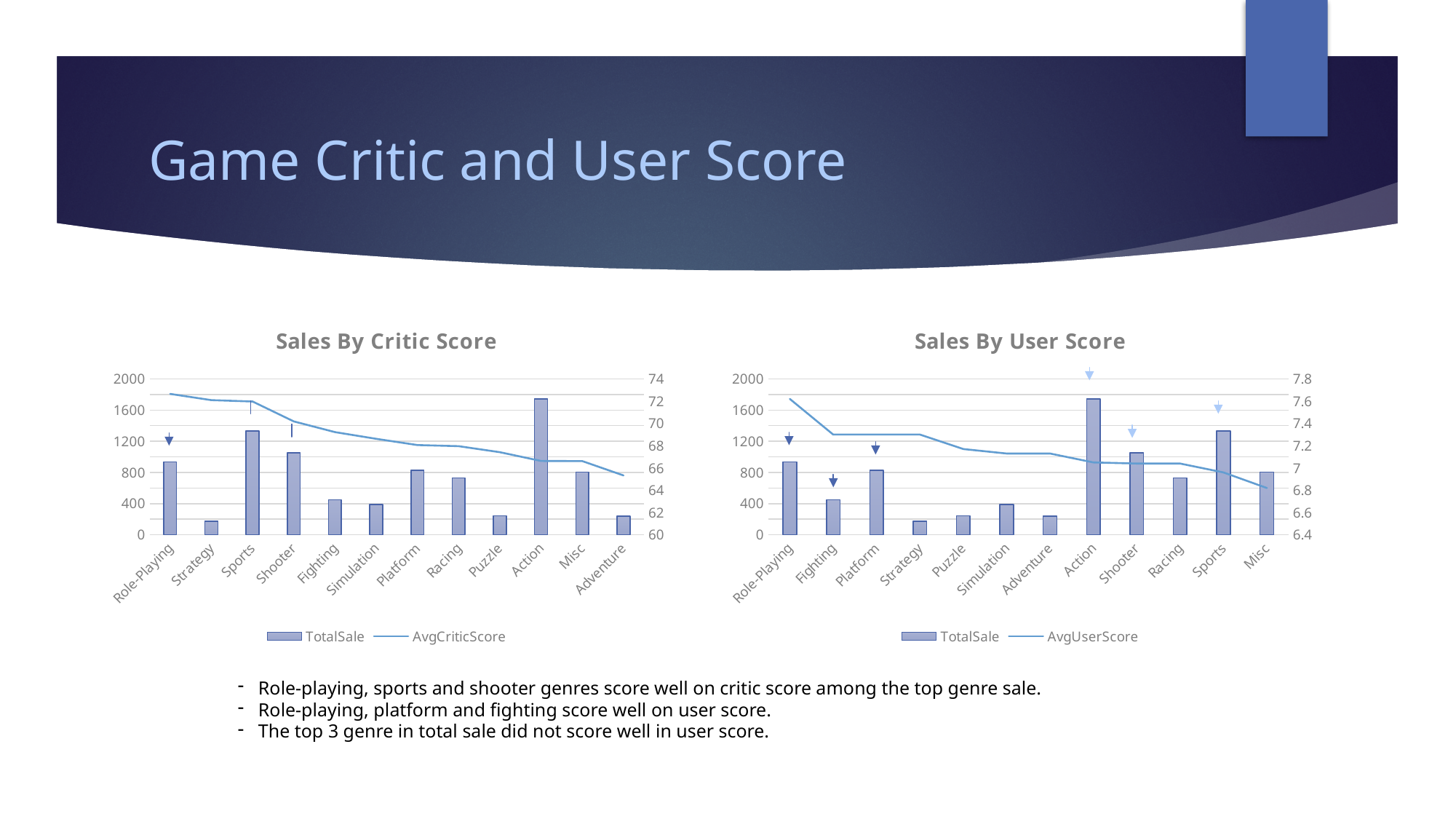
In the "Sales By Critic Score" chart, is the TotalSale value for Strategy greater or less than 400? less In the "Sales By Critic Score" chart, does the AvgCriticScore line generally rise or fall from left to right? fall In the "Sales By Critic Score" chart, which genre has the highest TotalSale bar? Action In the "Sales By User Score" chart, what are the two legend entries? TotalSale and AvgUserScore What type of chart is "Sales By Critic Score"? Combination bar and line chart In the "Sales By User Score" chart, is the TotalSale value for Role-Playing greater or less than 800? greater In the "Sales By Critic Score" chart, which has the larger TotalSale bar, Sports or Shooter? Sports In the "Sales By Critic Score" chart, how many genre categories are shown on the x axis? 12 In the "Sales By Critic Score" chart, how many series does the legend list? 2 In the "Sales By User Score" chart, which has the larger TotalSale bar, Platform or Fighting? Platform In the "Sales By Critic Score" chart, is the TotalSale value for Action greater or less than 1600? greater In the "Sales By User Score" chart, which genre has the highest TotalSale bar? Action